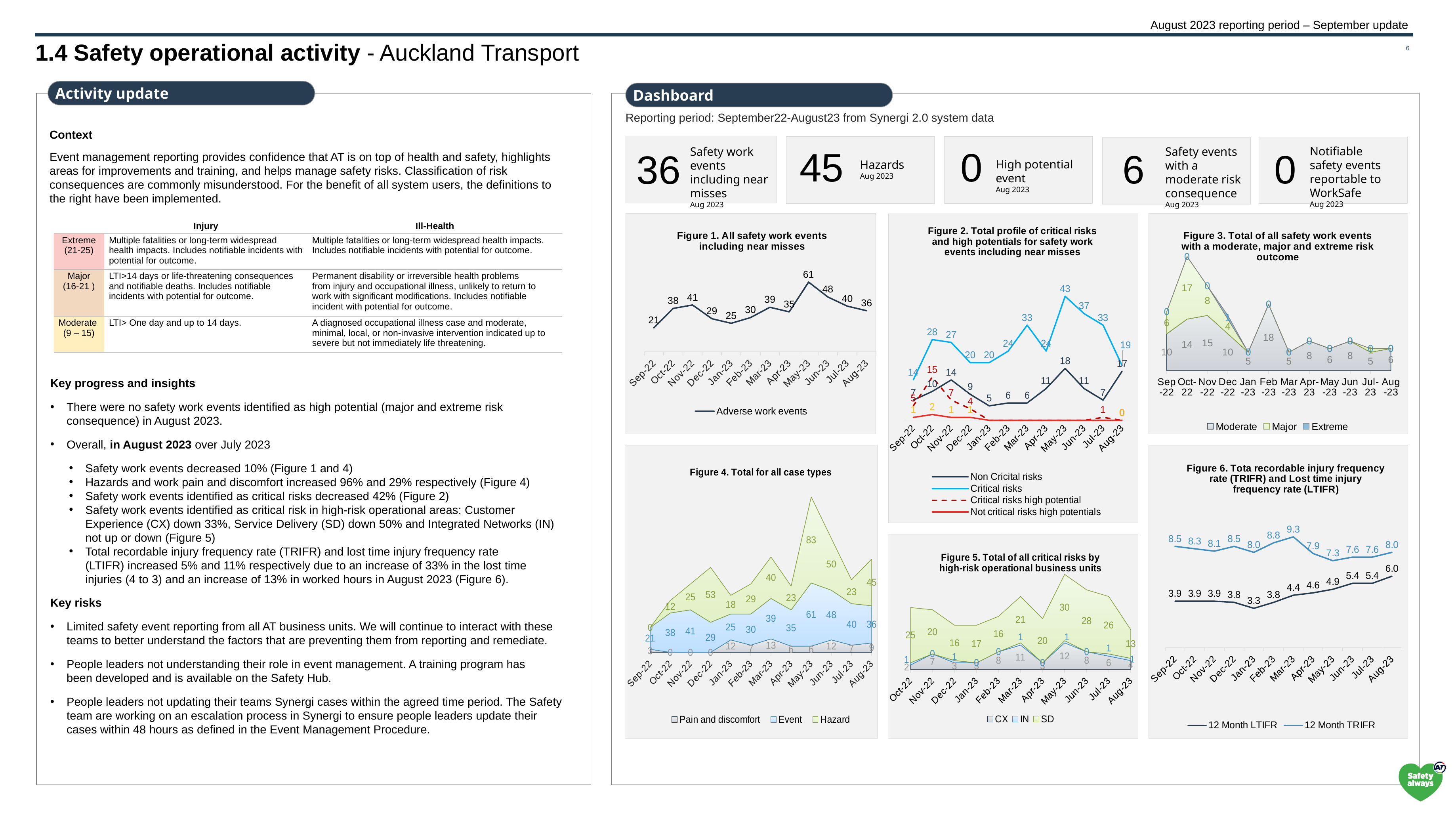
In Figure 1 (All safety work events including near misses), what is the difference between the May-23 and Aug-23 values? 25 In Figure 2 (Total profile of critical risks and high potentials), which is larger in Aug-23: Critical risks or Non Critical risks? Critical risks In Figure 5 (Total of all critical risks by high-risk operational business units), what is the SD value for May-23? 30 How many series does the legend of Figure 2 (Total profile of critical risks and high potentials) list? 4 In Figure 6 (TRIFR and LTIFR), which month has the highest 12 Month TRIFR value? Mar-23 What kind of chart is Figure 6 (TRIFR and LTIFR)? Line chart How many data points are plotted in Figure 1 (All safety work events including near misses)? 12 In Figure 2 (Total profile of critical risks and high potentials), what is the Critical risks value for May-23? 43 In Figure 6 (TRIFR and LTIFR), what is the 12 Month LTIFR value for Aug-23? 6.0 In Figure 6 (TRIFR and LTIFR), does the 12 Month LTIFR generally rise or fall from Jan-23 to Aug-23? Rise In Figure 1 (All safety work events including near misses), what is the value for May-23? 61 In Figure 1 (All safety work events including near misses), which month has the lowest value? Sep-22